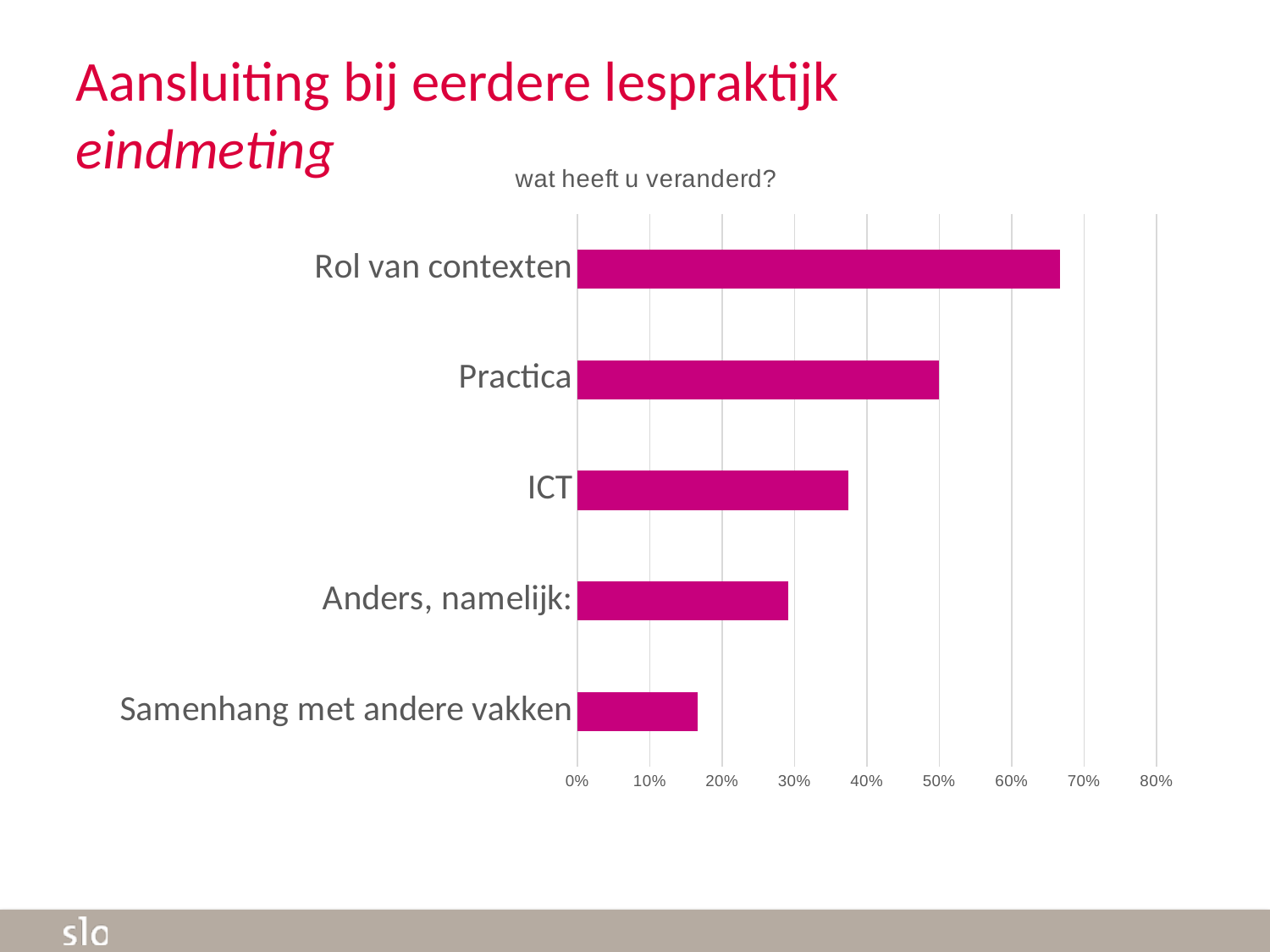
Is the value for Rol van contexten greater or less than 60%? greater What is the highest value shown on the horizontal axis? 80% Is the value for ICT greater or less than 40%? less Which category has the lowest value? Samenhang met andere vakken What is the value for Practica? 50% What kind of chart is shown on the slide? bar chart What is the title of the chart? wat heeft u veranderd? Which is larger, the value for ICT or the value for Practica? Practica Which category has the highest value? Rol van contexten Is the value for Anders, namelijk: greater or less than 20%? greater How many categories are shown in the chart? 5